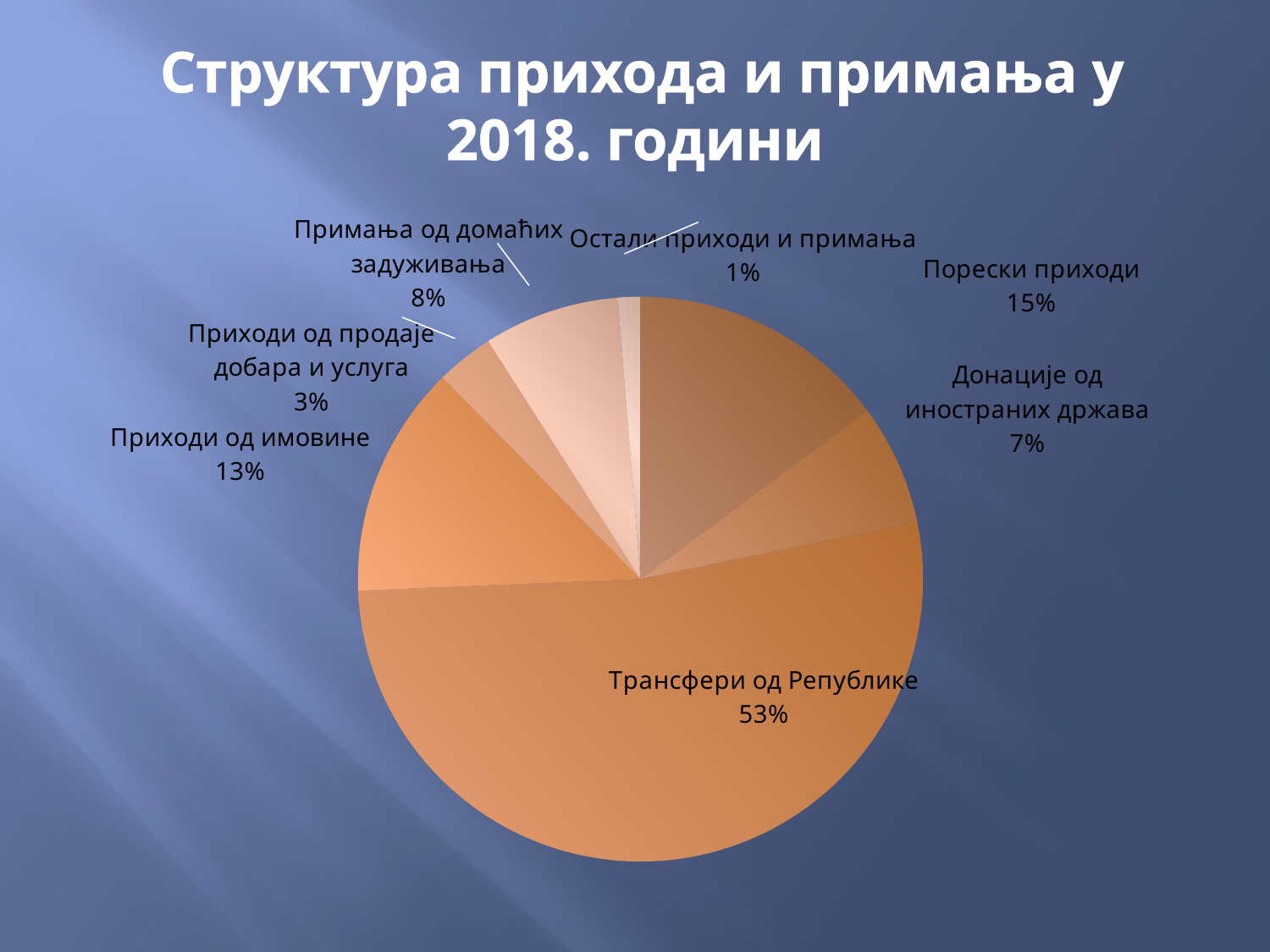
What is the value shown for Приходи од имовине? 13% What is the value shown for Порески приходи? 15% What is the difference in percentage points between Порески приходи and Приходи од имовине? 2% What is the value shown for Донације од иностраних држава? 7% How many slices does the pie chart have? 7 Which is larger, Примања од домаћих задуживања or Донације од иностраних држава? Примања од домаћих задуживања Which category has the smallest slice of the pie? Остали приходи и примања What share of the pie does Трансфери од Републике account for? 53% What is the title of the slide? Структура прихода и примања у 2018. години Which category has the largest slice of the pie? Трансфери од Републике What type of chart is shown on the slide? Pie chart What is the value shown for Примања од домаћих задуживања? 8%